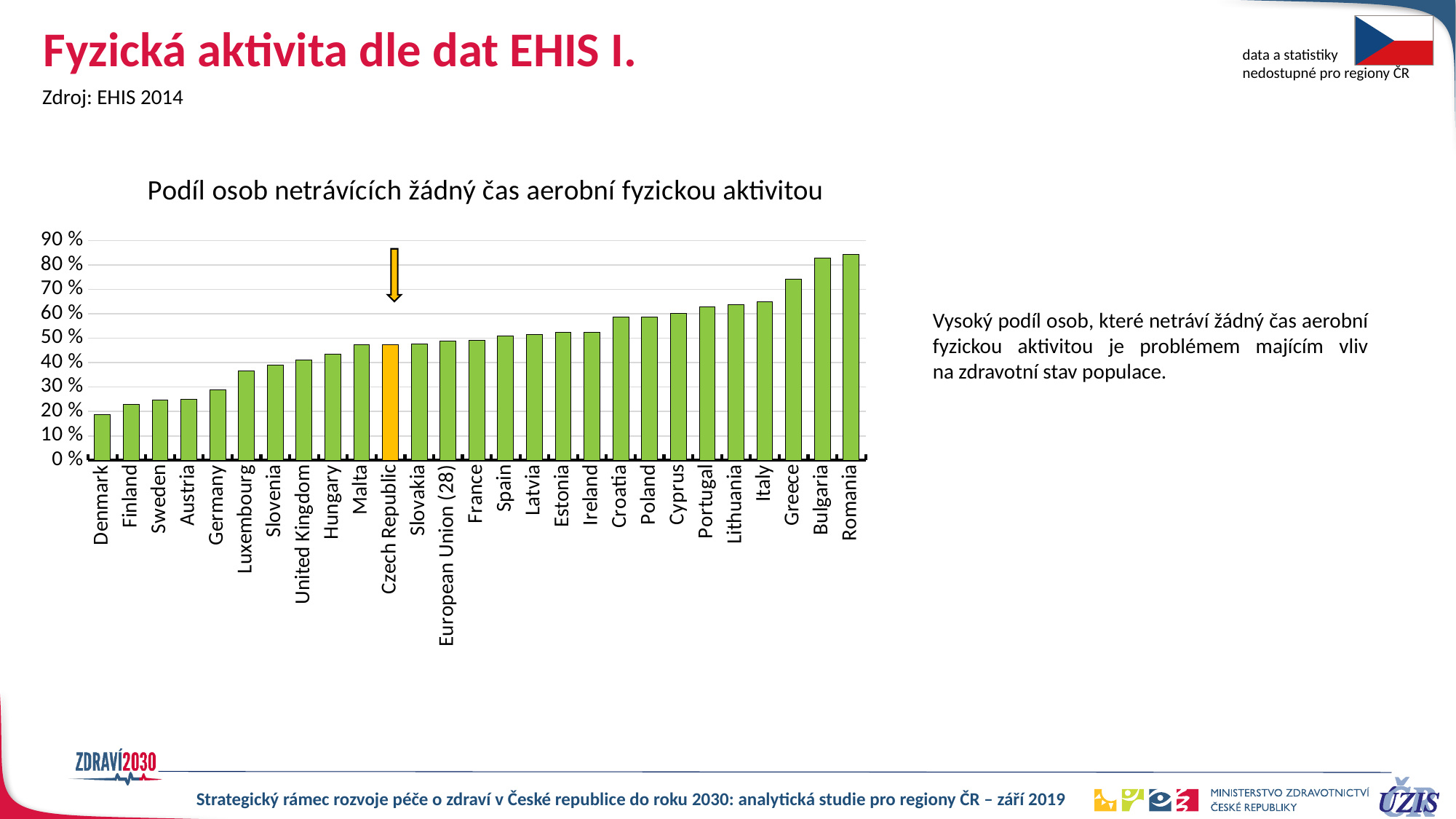
Which category has the lowest value in the chart? Denmark Which has the larger value, Poland or Sweden? Poland Is the value for Romania greater or less than 80 %? greater Is the value for Luxembourg greater or less than 30 %? greater Which has the larger value, Greece or Italy? Greece Do the values rise or fall from left to right along the x axis? rise Is the value for Denmark greater or less than 20 %? less What kind of chart is shown on the slide? bar chart Which country's bar is highlighted in orange with an arrow above it? Czech Republic How many countries/categories are plotted on the x axis of the chart? 27